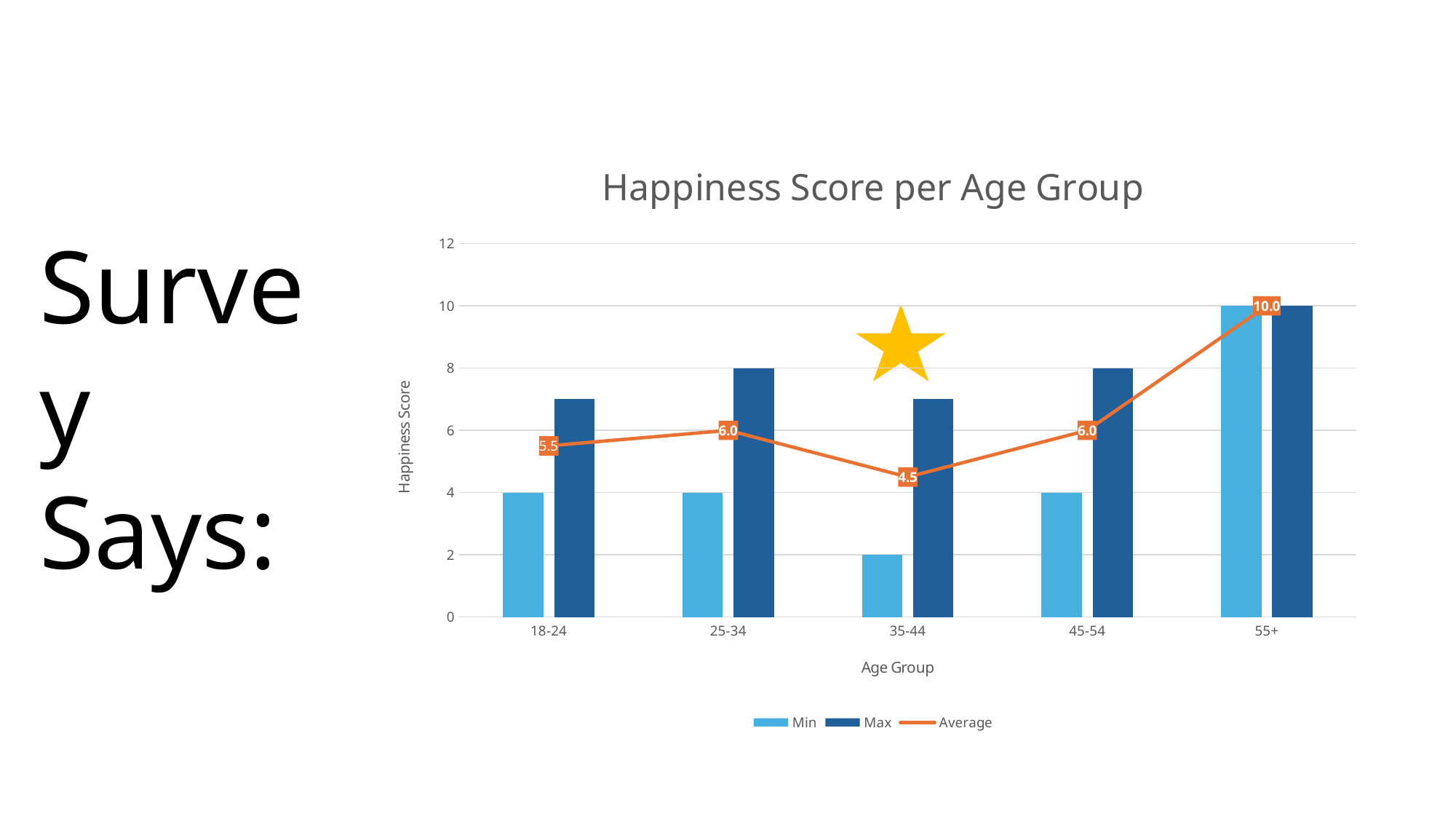
Is the Max happiness score for the 18-24 age group greater or less than 6? greater What is the Average happiness score for the 35-44 age group? 4.5 Which age group has the highest Average happiness score? 55+ What is the Max happiness score for the 25-34 age group? 8 How many age groups are shown on the x axis? 5 How many series does the legend list? 3 Which age group has a higher Average happiness score, 18-24 or 25-34? 25-34 Which age group has the lowest Average happiness score? 35-44 What is the Min happiness score for the 35-44 age group? 2 What is the Average happiness score for the 55+ age group? 10.0 What is the difference between the Average happiness score for 55+ and for 35-44? 5.5 Does the Average happiness score rise or fall from the 35-44 group to the 55+ group? rise